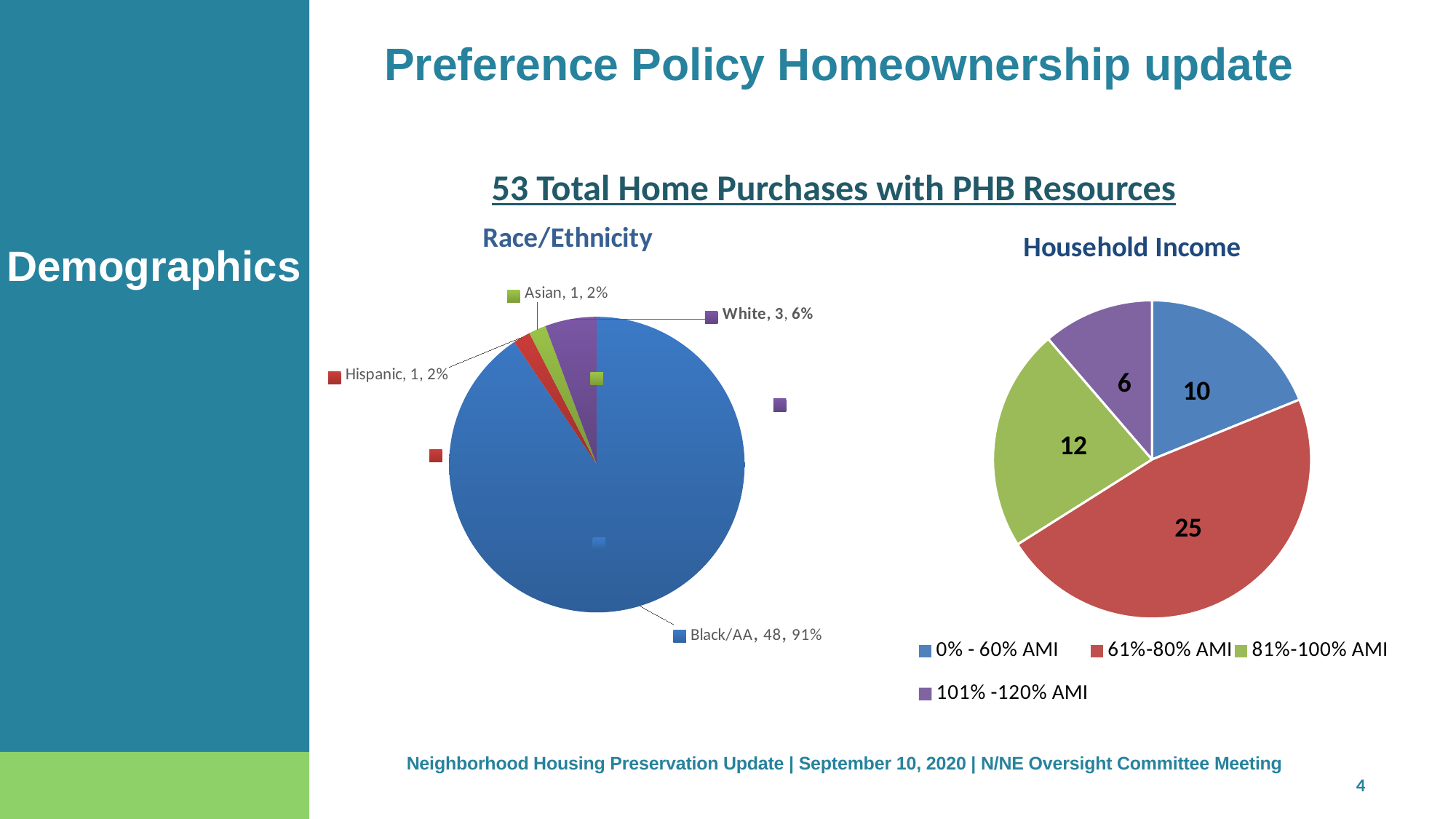
In the Race/Ethnicity chart, how many categories are shown? 4 In the Race/Ethnicity chart, what is the difference between the Black/AA count and the White count? 45 In the Race/Ethnicity chart, which category has the largest slice? Black/AA In the Race/Ethnicity chart, how many home purchases were by White buyers? 3 How many entries does the legend of the Household Income chart list? 4 In the Household Income chart, which is larger: 0% - 60% AMI or 81%-100% AMI? 81%-100% AMI In the Race/Ethnicity chart, what share of the pie does Black/AA represent? 91% What type of chart is the Race/Ethnicity chart? pie chart In the Race/Ethnicity chart, how many home purchases were by Black/AA buyers? 48 In the Household Income chart, how many purchases were in the 61%-80% AMI group? 25 In the Household Income chart, how many purchases were in the 101% -120% AMI group? 6 In the Household Income chart, which income group has the smallest slice? 101% -120% AMI